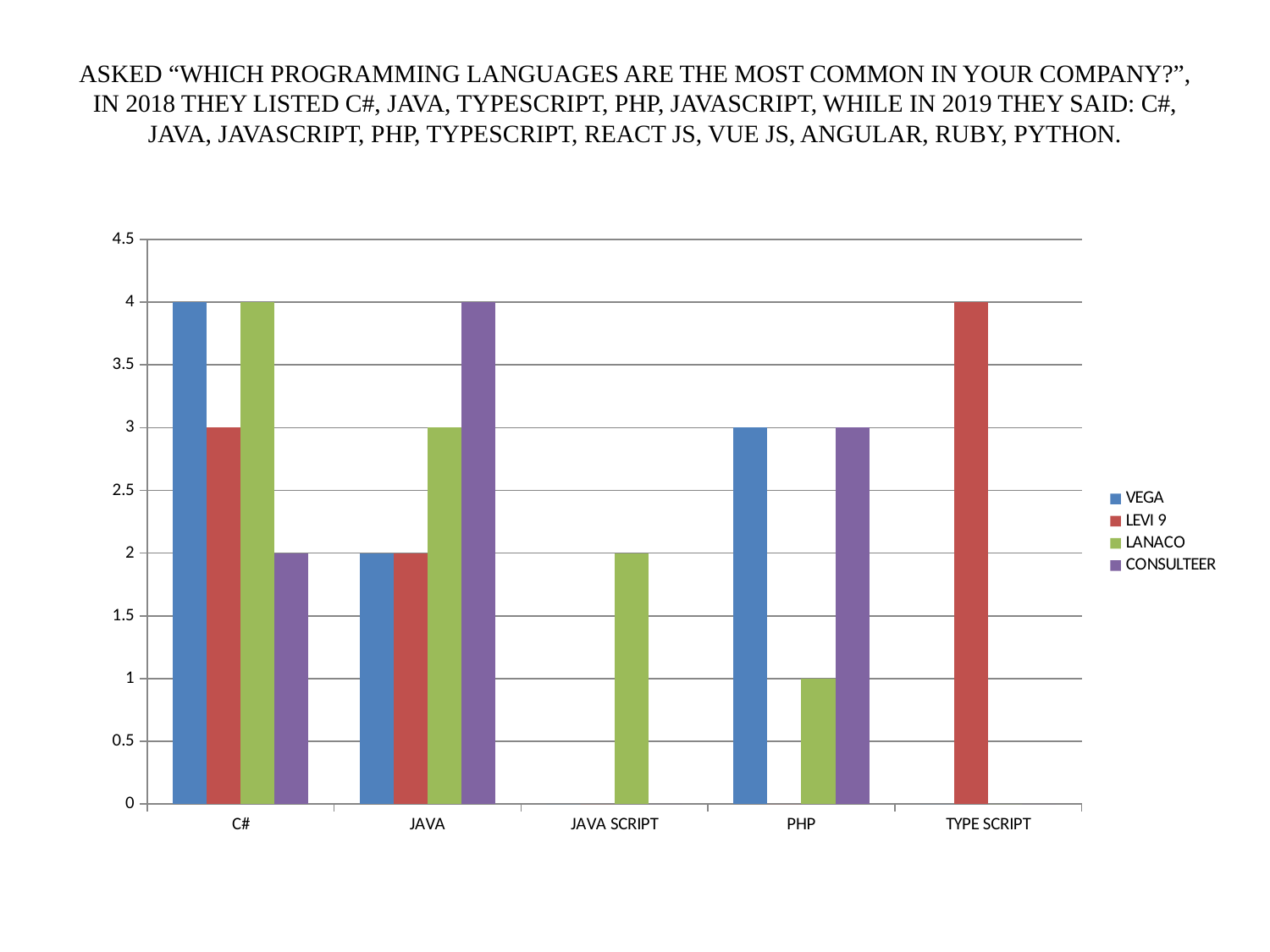
What is the value for VEGA in the C# category? 4 What is the value for LANACO in the PHP category? 1 Which series is the only one with a bar in the JAVA SCRIPT category? LANACO What is the value for LEVI 9 in the TYPE SCRIPT category? 4 What is the difference between the VEGA and CONSULTEER values in the C# category? 2 What is the value for CONSULTEER in the JAVA category? 4 Which is larger in the PHP category, the value for VEGA or the value for LANACO? VEGA How many programming language categories are shown on the x axis? 5 What kind of chart is shown on the slide? bar chart How many series does the legend list? 4 Which series has the lowest value in the C# category? CONSULTEER Which series has the highest value in the JAVA category? CONSULTEER